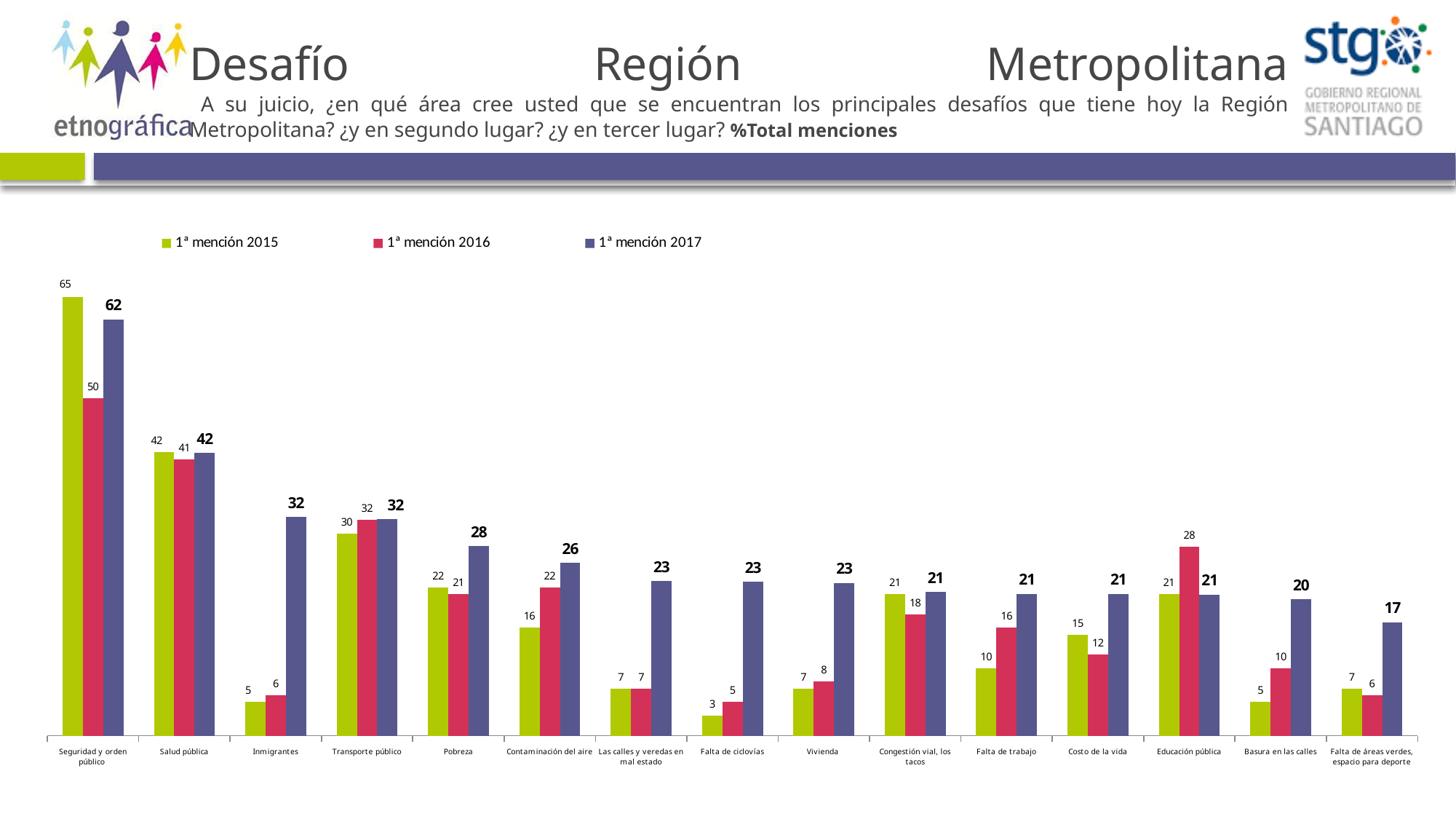
How many series does the legend list? 3 Which series is shown in green in the legend? 1ª mención 2015 How many categories are shown on the x axis of the chart? 15 What is the difference between the 1ª mención 2017 and 1ª mención 2015 values for Inmigrantes? 27 What kind of chart is shown on the slide? Bar chart What is the value for Seguridad y orden público in the 1ª mención 2015 series? 65 Which category has the lowest value in the 1ª mención 2015 series? Falta de ciclovías Which is larger for Contaminación del aire: the 1ª mención 2016 value or the 1ª mención 2017 value? 1ª mención 2017 What is the value for Inmigrantes in the 1ª mención 2017 series? 32 Which category has the highest value in the 1ª mención 2017 series? Seguridad y orden público What is the difference between the 1ª mención 2015 and 1ª mención 2016 values for Seguridad y orden público? 15 What is the value for Educación pública in the 1ª mención 2016 series? 28